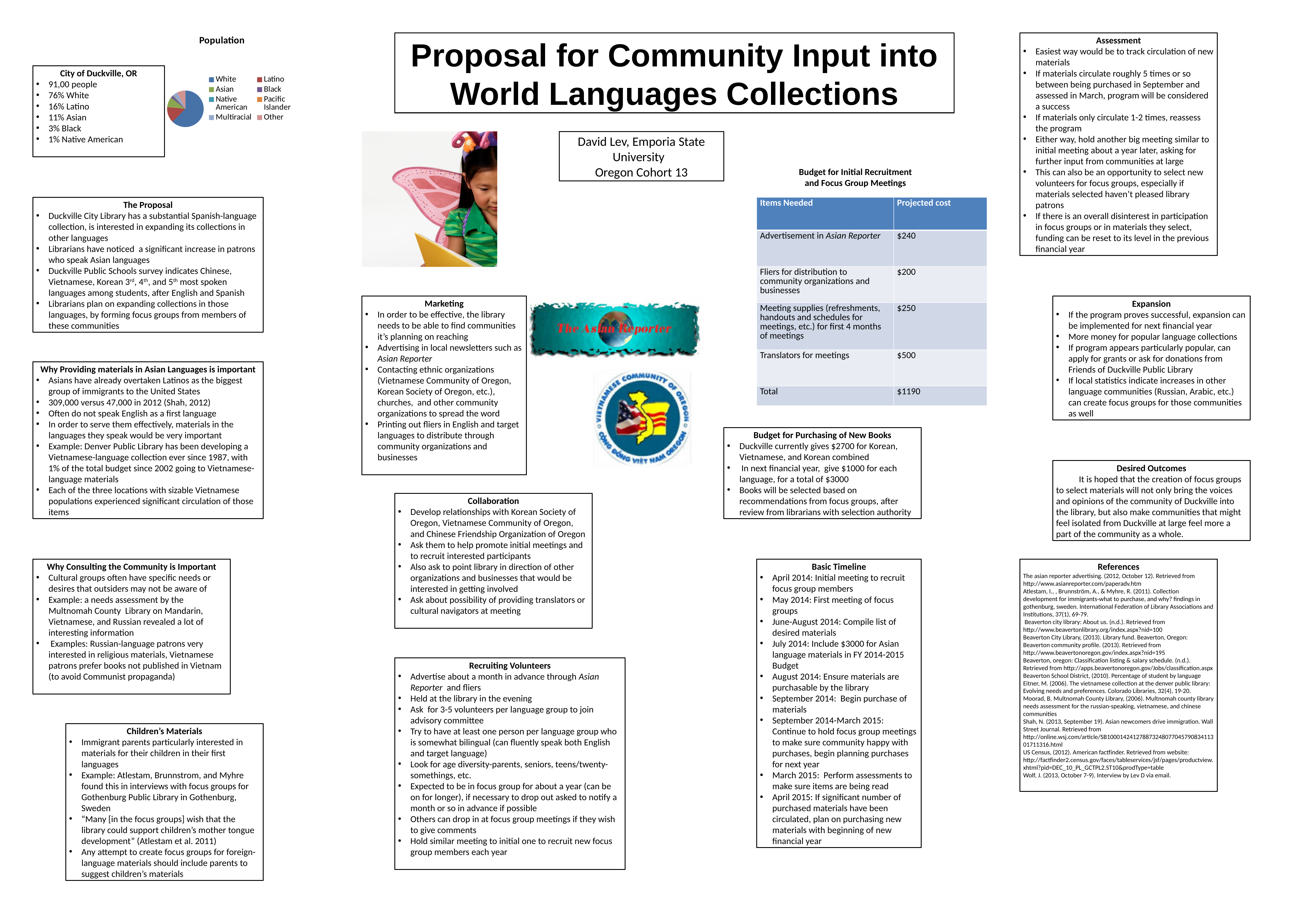
What kind of chart is the "Population" chart? pie chart In the "Population" pie chart, which slice is larger: White or Asian? White Which category has the largest slice in the "Population" pie chart? White How many entries does the legend of the "Population" pie chart list? 8 What is the title of the pie chart in the top-left of the slide? Population In the "Population" pie chart, which slice is larger: White or Latino? White What colour is the White slice in the "Population" pie chart? blue